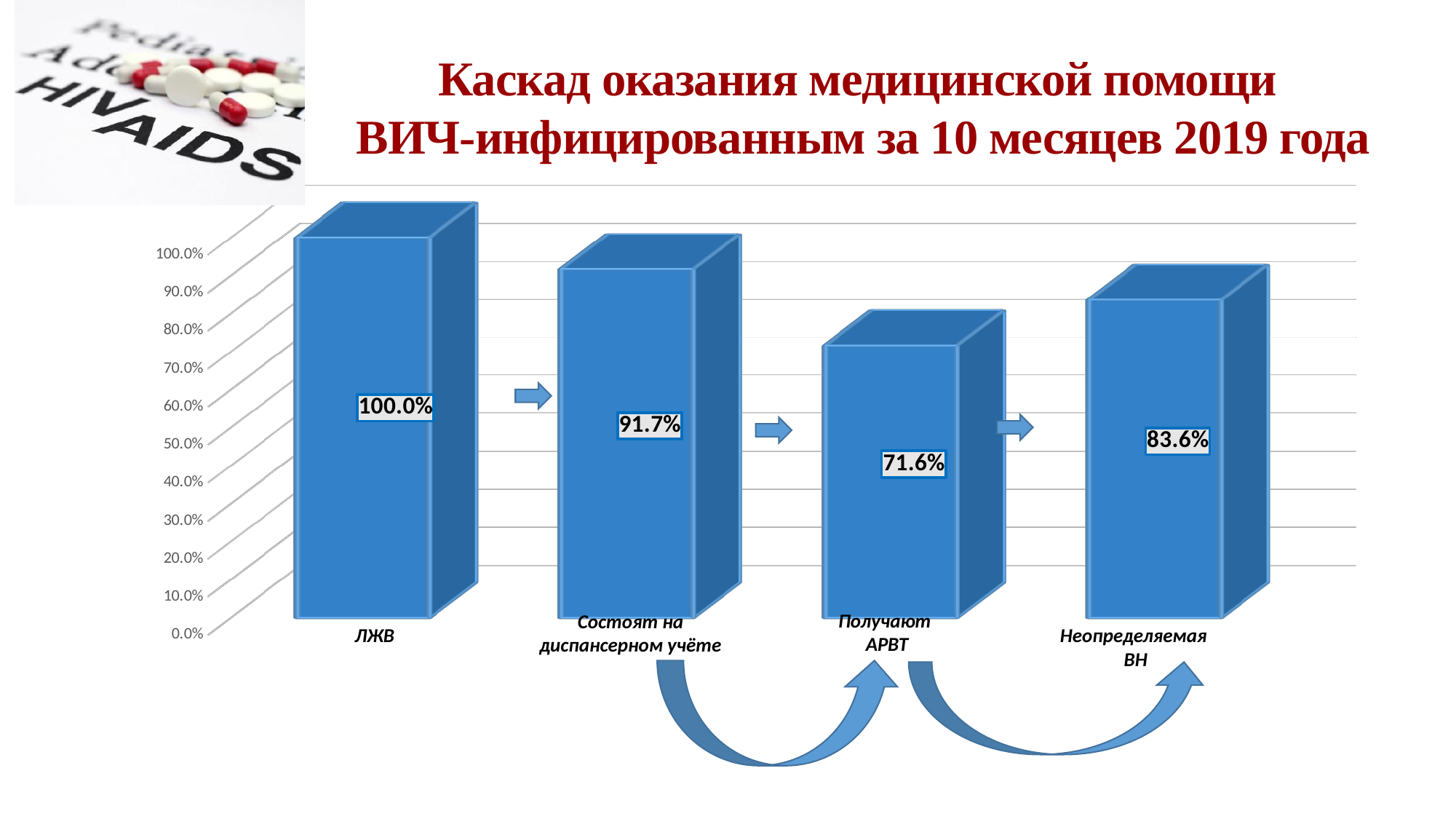
What is the difference between the values for Состоят на диспансерном учёте and Получают АРВТ? 20.1% Which is larger, the value for Неопределяемая ВН or the value for Получают АРВТ? Неопределяемая ВН What is the value for Неопределяемая ВН? 83.6% What is the value for Состоят на диспансерном учёте? 91.7% What kind of chart is shown on the slide? Bar chart What is the difference between the values for ЛЖВ and Неопределяемая ВН? 16.4% Which category has the lowest value? Получают АРВТ What is the title of the slide? Каскад оказания медицинской помощи ВИЧ-инфицированным за 10 месяцев 2019 года What is the value for ЛЖВ? 100.0% How many categories are shown in the chart? 4 What is the value for Получают АРВТ? 71.6% Which category has the highest value? ЛЖВ